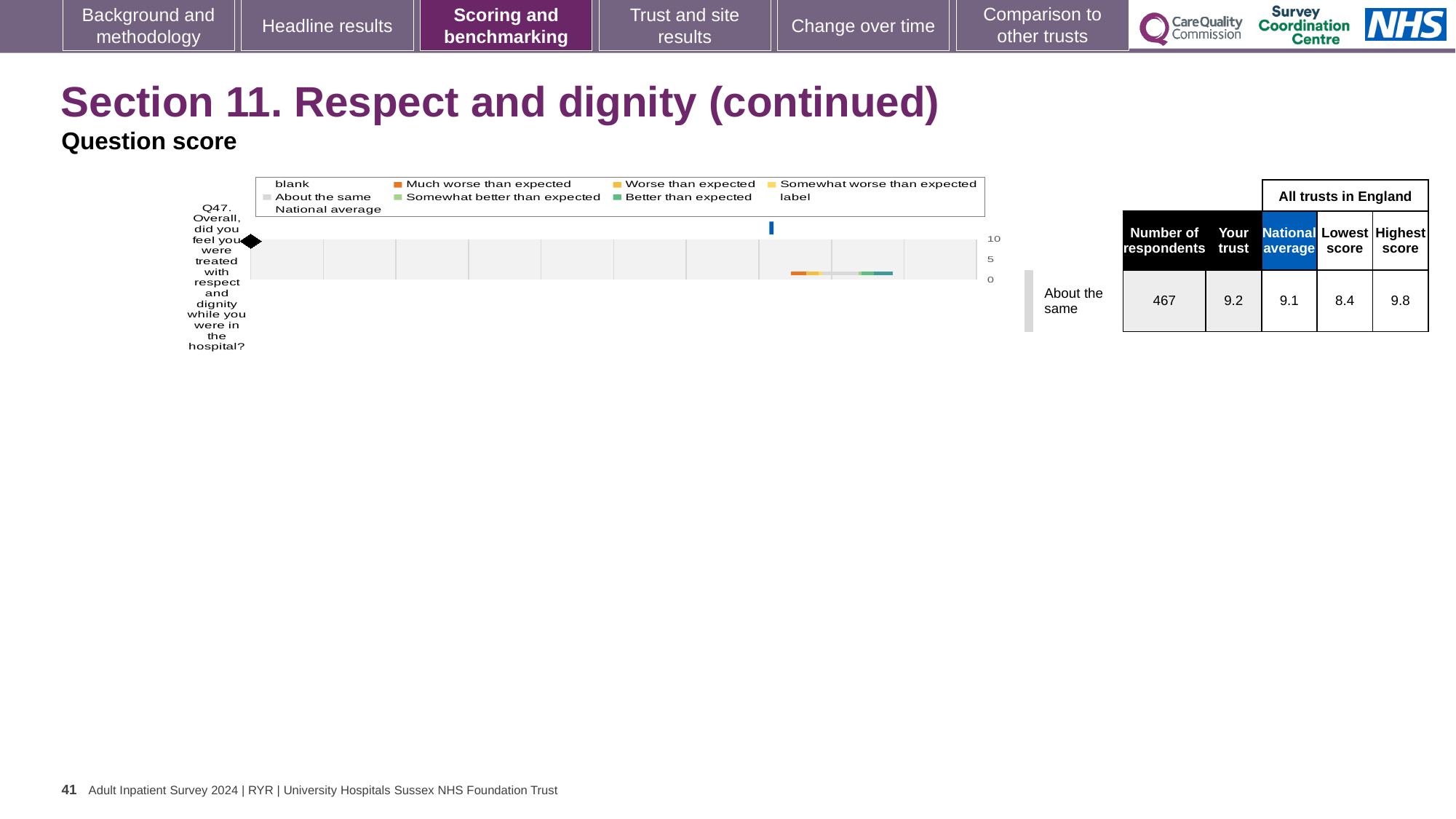
What is the 'Your trust' score for Q47? 9.2 For Q47, which is larger: the 'Your trust' score or the national average? Your trust What is the benchmark category shown for Q47 next to the chart? About the same What is the highest score among all trusts in England for Q47? 9.8 Which question is plotted in the chart? Q47. Overall, did you feel you were treated with respect and dignity while you were in the hospital? What is the difference between the highest score and the lowest score for Q47? 1.4 What is the difference between the 'Your trust' score and the national average for Q47? 0.1 How many respondents answered Q47? 467 How many questions (categories) are plotted in the chart? 1 What kind of chart is shown on the slide for Q47? bar chart What is the lowest score among all trusts in England for Q47? 8.4 What is the national average score for Q47? 9.1